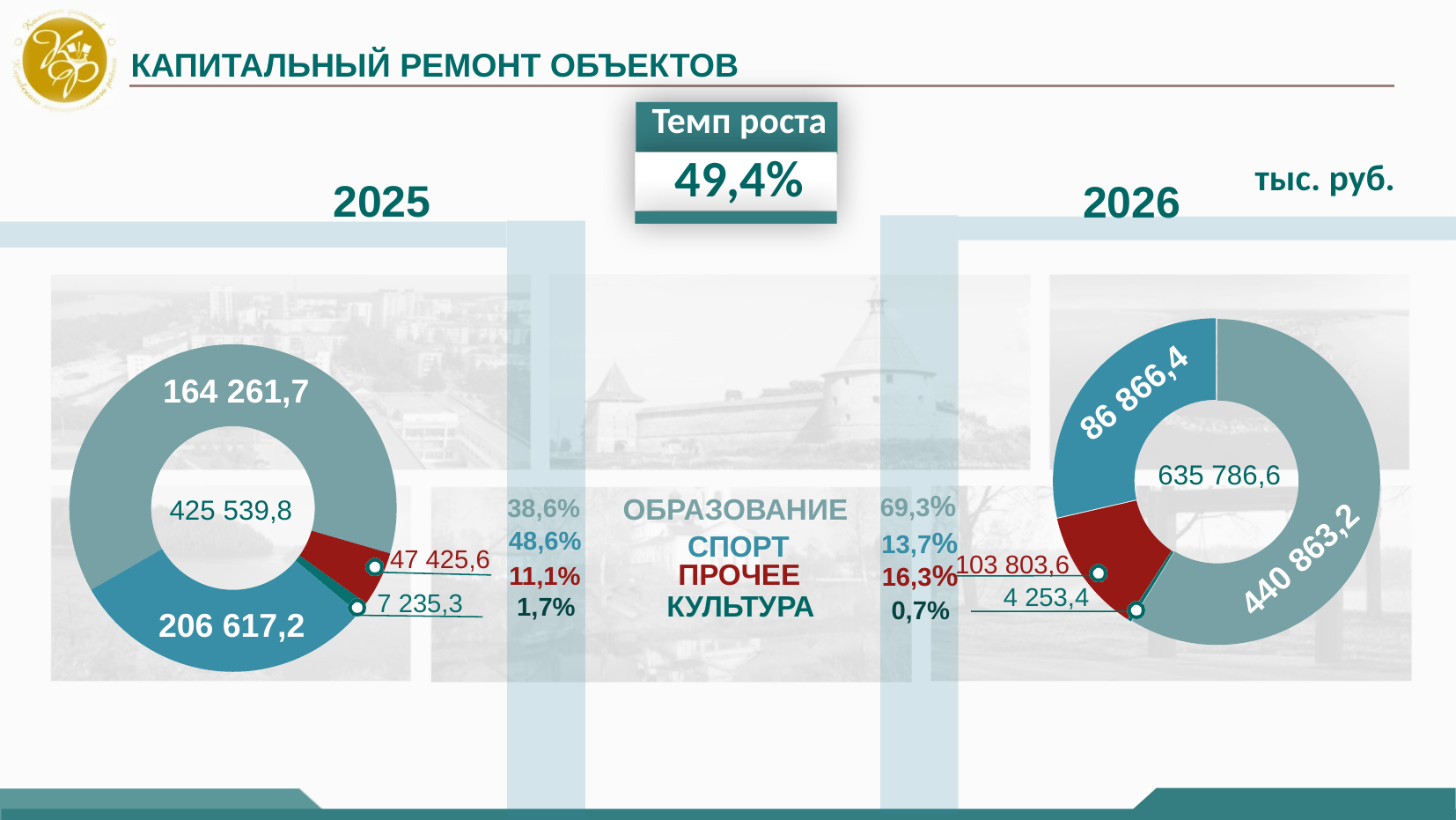
In the 2026 chart, what share of the total does СПОРТ represent? 13,7% In the 2026 chart, what is the value for ПРОЧЕЕ? 103 803,6 What type of chart is used for the 2025 and 2026 data? Donut (pie) chart Which is larger: ОБРАЗОВАНИЕ in 2025 or ОБРАЗОВАНИЕ in 2026? 2026 In the 2025 chart, what is the value for КУЛЬТУРА? 7 235,3 In the 2026 chart, which category has the smallest value? КУЛЬТУРА In the 2025 chart, what is the value for СПОРТ? 206 617,2 What is the total shown in the centre of the 2026 chart? 635 786,6 In the 2026 chart, what is the value for ОБРАЗОВАНИЕ? 440 863,2 In the 2025 chart, which category has the largest value? СПОРТ What is the difference between the 2026 and 2025 values for ПРОЧЕЕ? 56 378,0 In the 2025 chart, what share of the total does ПРОЧЕЕ represent? 11,1%